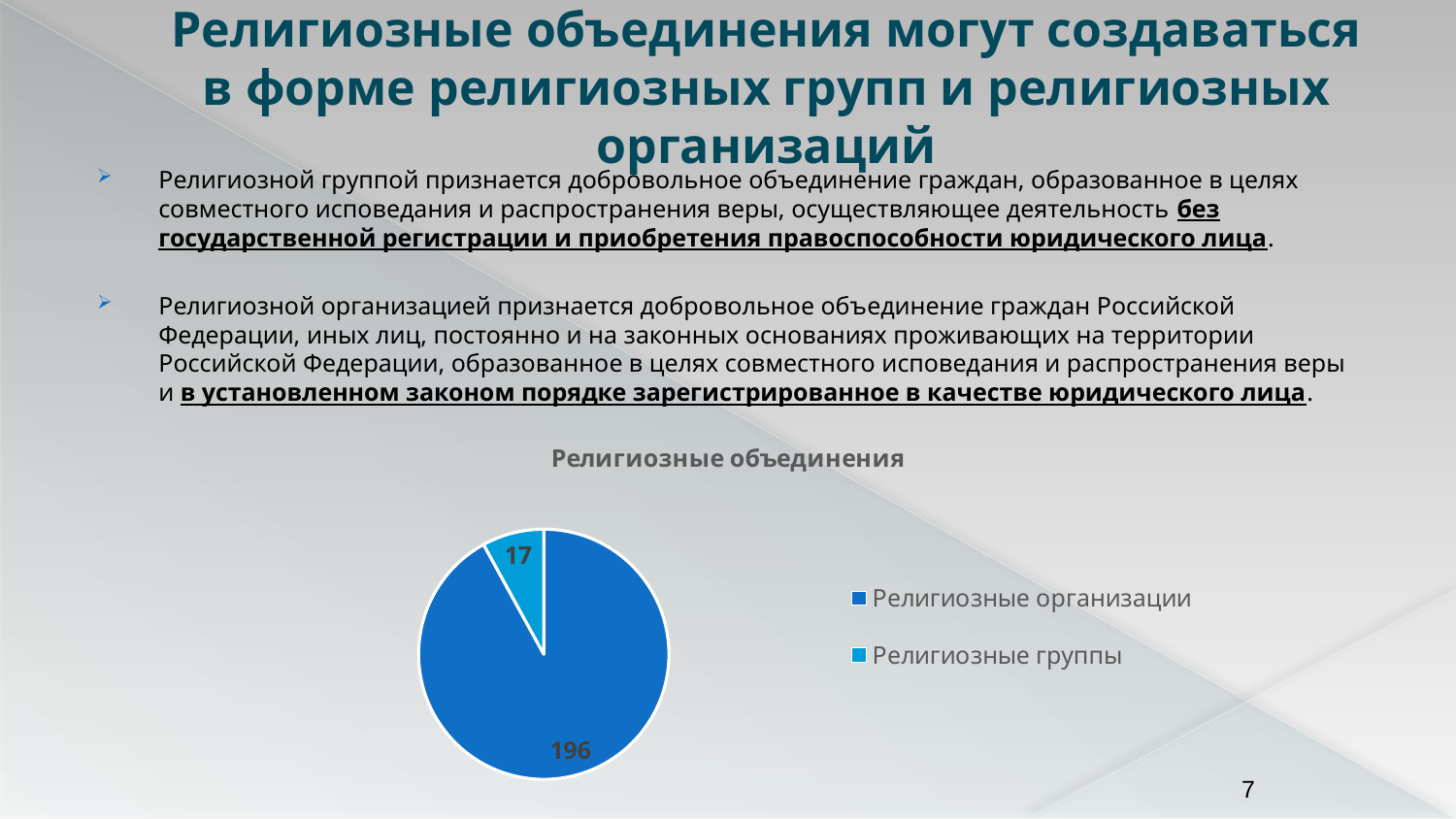
What kind of chart is shown on the slide? Pie chart What is the difference between the values for Религиозные организации and Религиозные группы? 179 What is the total of all slices in the pie chart? 213 Which category has the largest slice in the pie chart? Религиозные организации How many slices does the pie chart have? 2 What is the value for Религиозные группы in the pie chart? 17 What is the title of the chart? Религиозные объединения What share of the pie does Религиозные организации represent, rounded to the nearest whole percent? 92% Which is larger: the value for Религиозные организации or for Религиозные группы? Религиозные организации What is the value for Религиозные организации in the pie chart? 196 Which category has the smallest slice in the pie chart? Религиозные группы How many entries does the legend list? 2